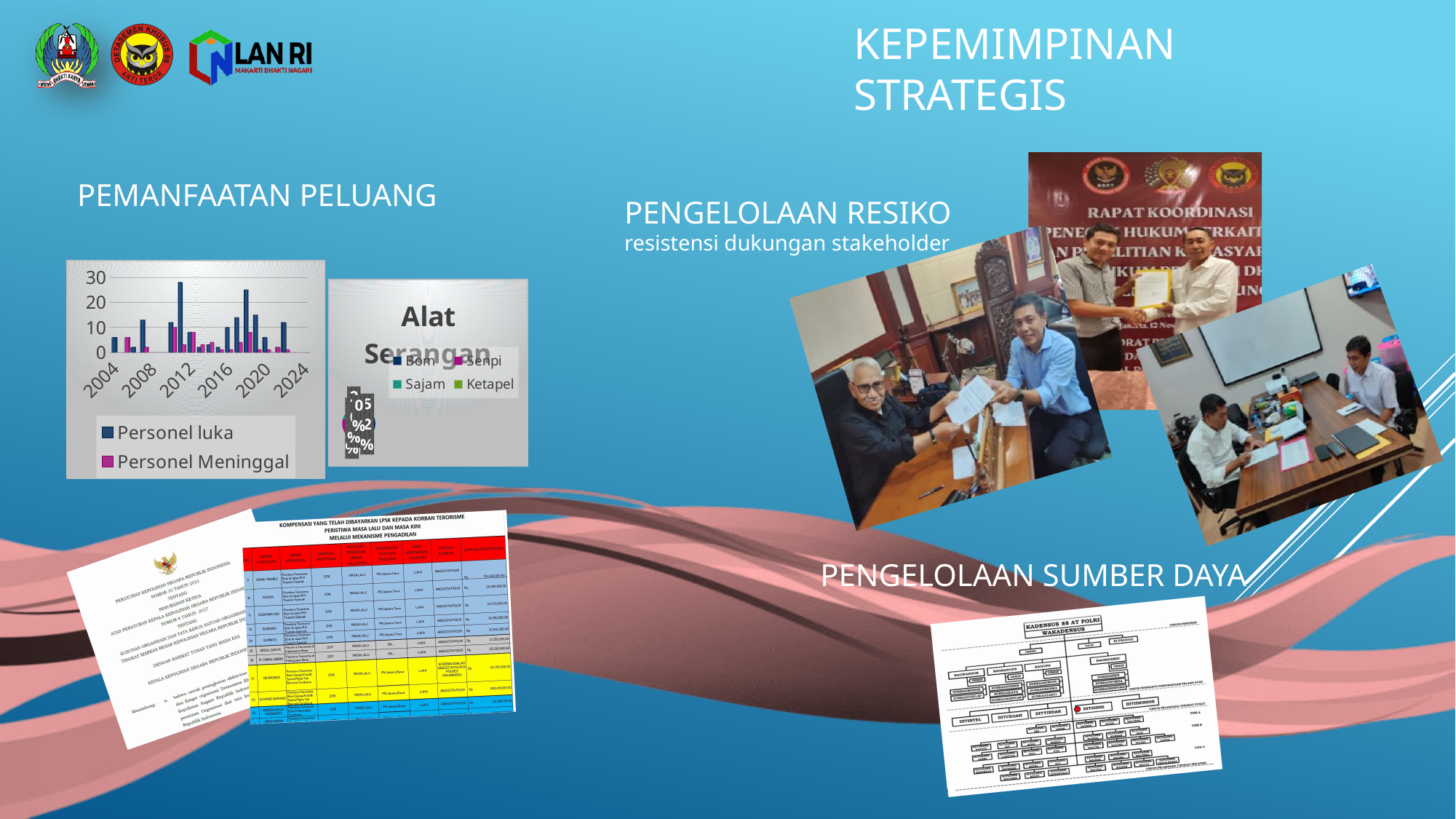
What kind of chart is the chart on the left with the legend 'Personel luka' and 'Personel Meninggal'? bar chart How many series does the legend of the 'Personel luka' / 'Personel Meninggal' bar chart list? 2 In the bar chart with 'Personel luka' and 'Personel Meninggal', what is the highest value shown on the vertical axis? 30 How many categories does the legend of the 'Alat Serangan' pie chart list? 4 In the bar chart with 'Personel luka' and 'Personel Meninggal', what is the first year label on the horizontal axis? 2004 What kind of chart is the 'Alat Serangan' chart? pie chart In the bar chart with 'Personel luka' and 'Personel Meninggal', what is the last year label on the horizontal axis? 2024 In the bar chart with 'Personel luka' and 'Personel Meninggal', is the tallest bar greater or less than 20? greater What are the legend entries of the 'Alat Serangan' pie chart? Bom, Senpi, Sajam, Ketapel In the bar chart with 'Personel luka' and 'Personel Meninggal', which series has the tallest bar? Personel luka